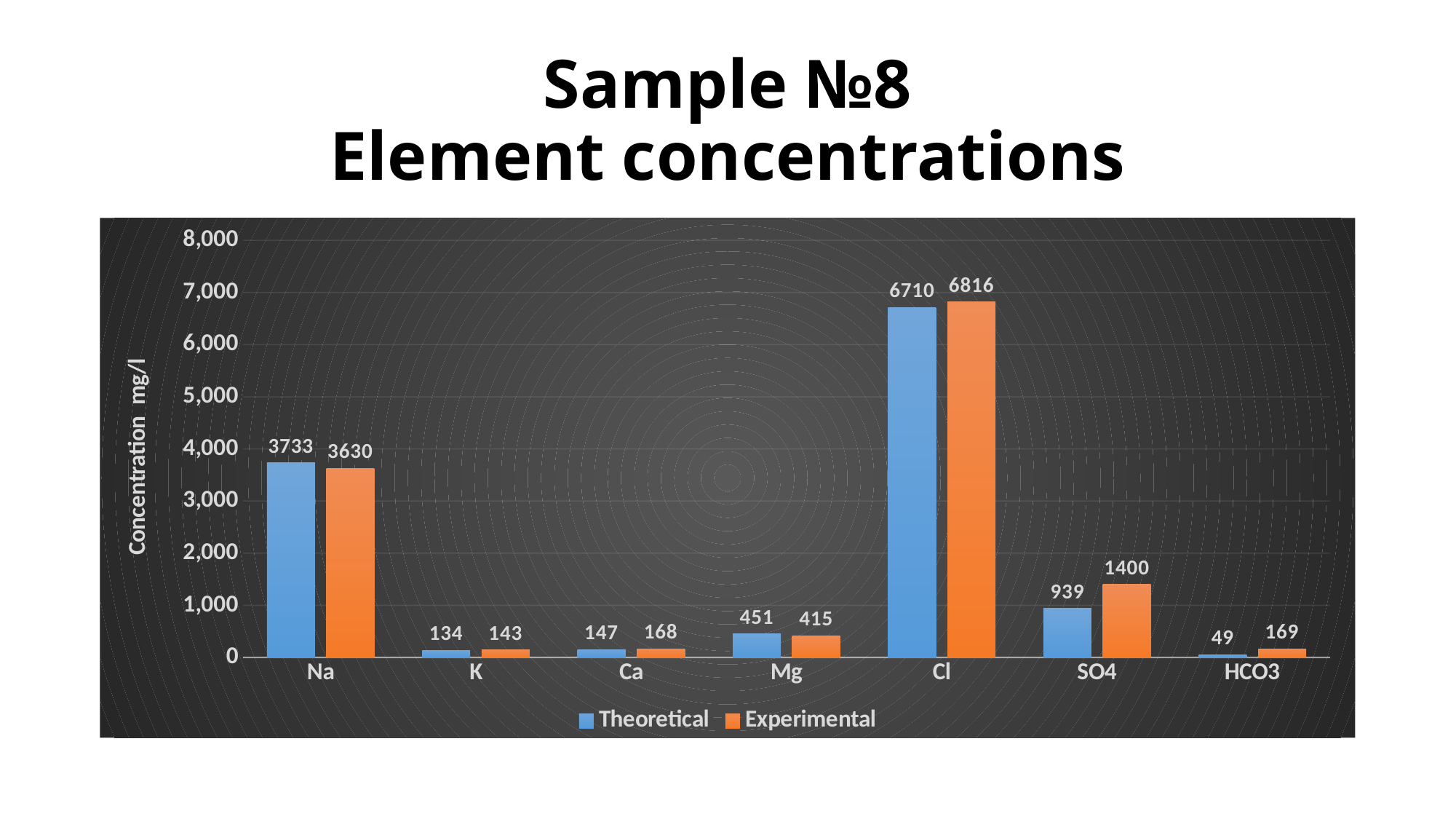
Which is larger for Mg, the Theoretical or the Experimental concentration? Theoretical What is the Theoretical concentration for Na? 3733 Which element has the lowest Theoretical concentration? HCO3 What is the difference between the Experimental and Theoretical concentrations for SO4? 461 Which element has the highest Experimental concentration? Cl What is the difference between the Experimental and Theoretical concentrations for Cl? 106 What is the Experimental concentration for HCO3? 169 How many elements are shown on the x axis? 7 How many series does the legend list? 2 What type of chart is shown on the slide? Bar chart Is the Theoretical concentration for Na greater or less than 3,000? greater What is the Experimental concentration for SO4? 1400